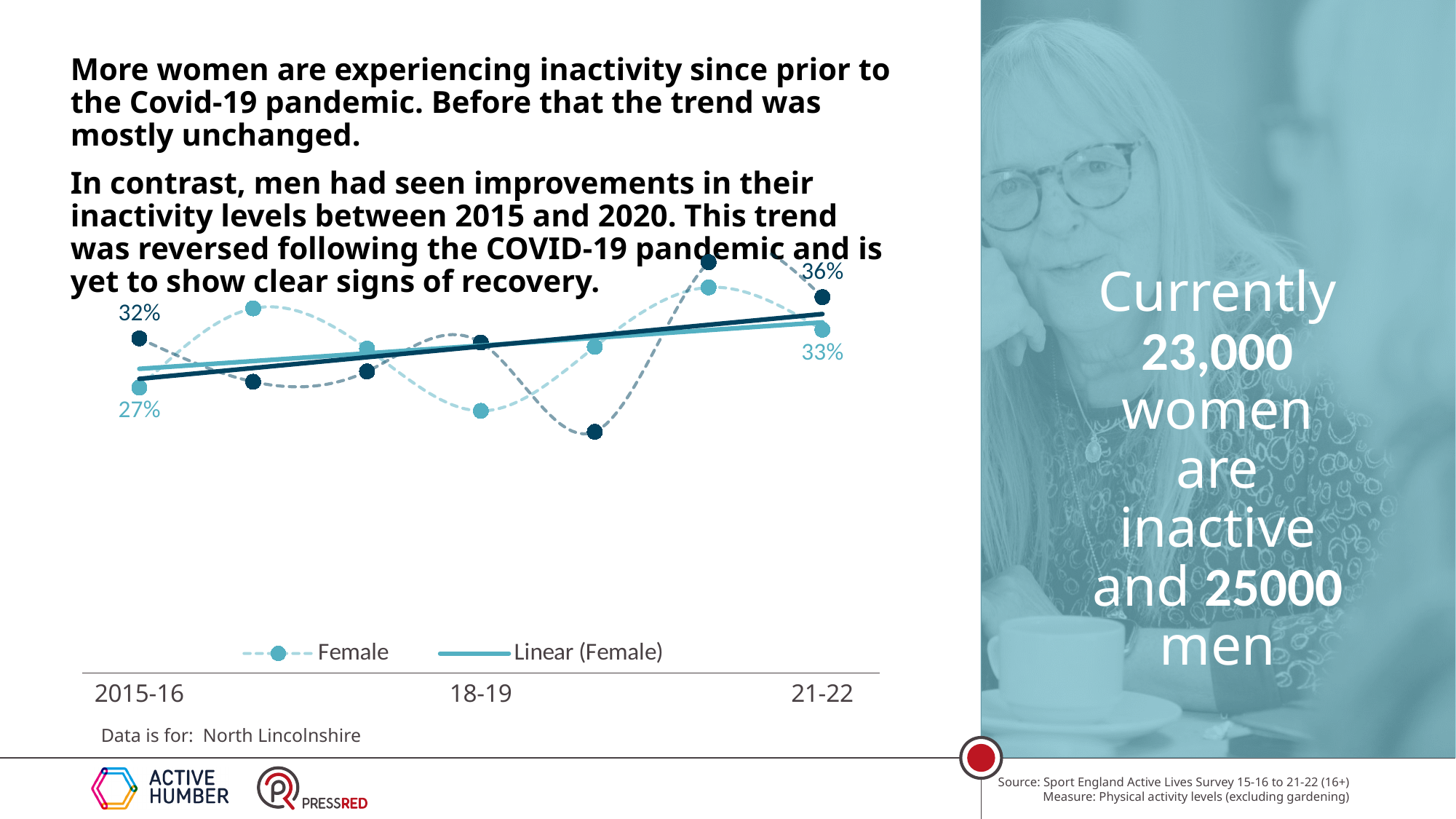
What kind of chart is shown on the slide? Line chart What is the value of the dark blue dashed series at 21-22? 36% What is the Female value at 2015-16? 27% What is the Female value at 21-22? 33% By how many percentage points did the Female value change from 2015-16 to 21-22? 6 percentage points What is the value of the dark blue dashed series at 2015-16? 32% Does the Linear (Female) trendline rise or fall from left to right? Rises How many data points are plotted on the Female line? 7 At 21-22, which is higher: the Female value or the dark blue dashed series value? The dark blue dashed series By how many percentage points did the dark blue dashed series change from 2015-16 to 21-22? 4 percentage points Which area does the chart's data cover, according to the note below the chart? North Lincolnshire How many entries does the chart legend list? 2